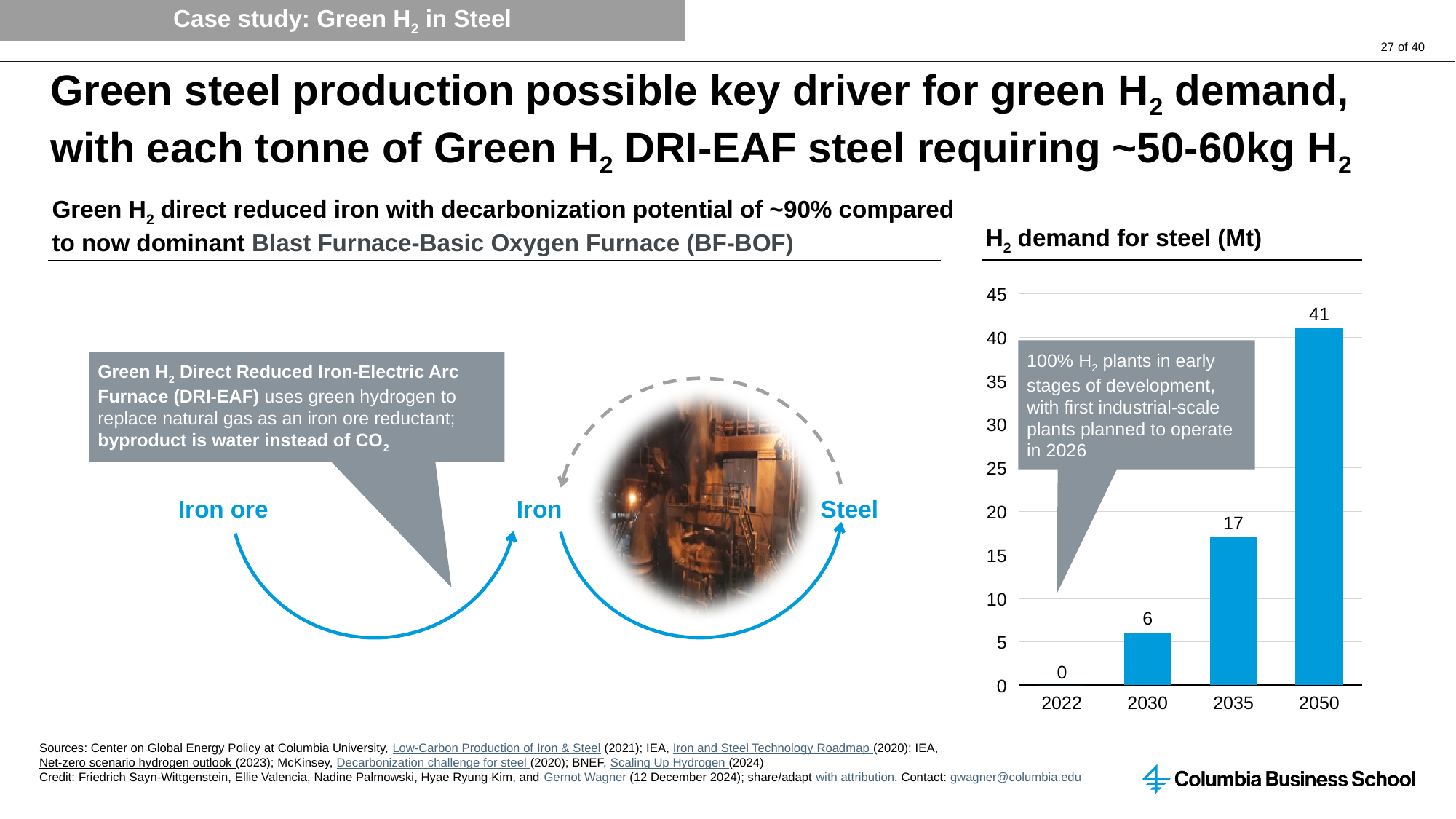
Which year has the highest H2 demand for steel? 2050 Which year has the lowest H2 demand for steel? 2022 How many years are shown on the x axis of the H2 demand for steel chart? 4 What is the H2 demand for steel in 2035? 17 Is the H2 demand for steel larger in 2030 or in 2035? 2035 What is the H2 demand for steel in 2022? 0 What is the difference in H2 demand for steel between 2050 and 2035? 24 What kind of chart is used to show H2 demand for steel? Bar chart Do the values in the H2 demand for steel chart rise or fall from 2022 to 2050? Rise What is the H2 demand for steel in 2030? 6 What is the difference in H2 demand for steel between 2035 and 2030? 11 What is the H2 demand for steel in 2050? 41